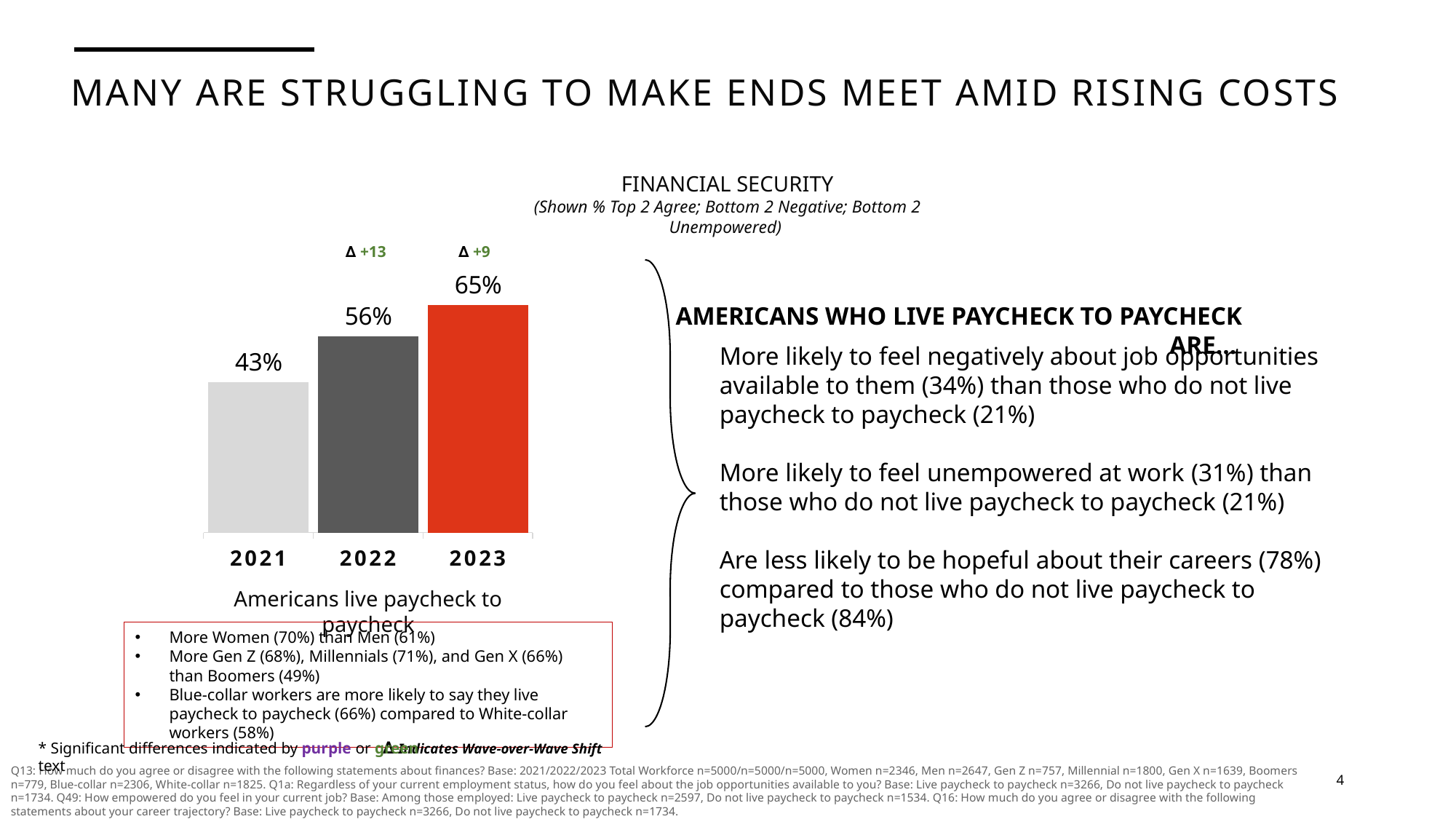
What wave-over-wave shift is shown above the 2023 bar? Δ +9 What is the difference in percentage points between the 2023 and 2021 values? 22 What type of chart is used to show Americans living paycheck to paycheck? Bar chart Which year has the lowest share of Americans living paycheck to paycheck? 2021 What percentage of Americans lived paycheck to paycheck in 2022? 56% Do the values rise or fall from 2021 to 2023? Rise What is the difference in percentage points between the 2022 and 2021 values? 13 Which year has the highest share of Americans living paycheck to paycheck? 2023 What percentage of Americans lived paycheck to paycheck in 2021? 43% How many years are shown in the chart? 3 Which is larger, the value for 2022 or the value for 2023? 2023 What percentage of Americans lived paycheck to paycheck in 2023? 65%